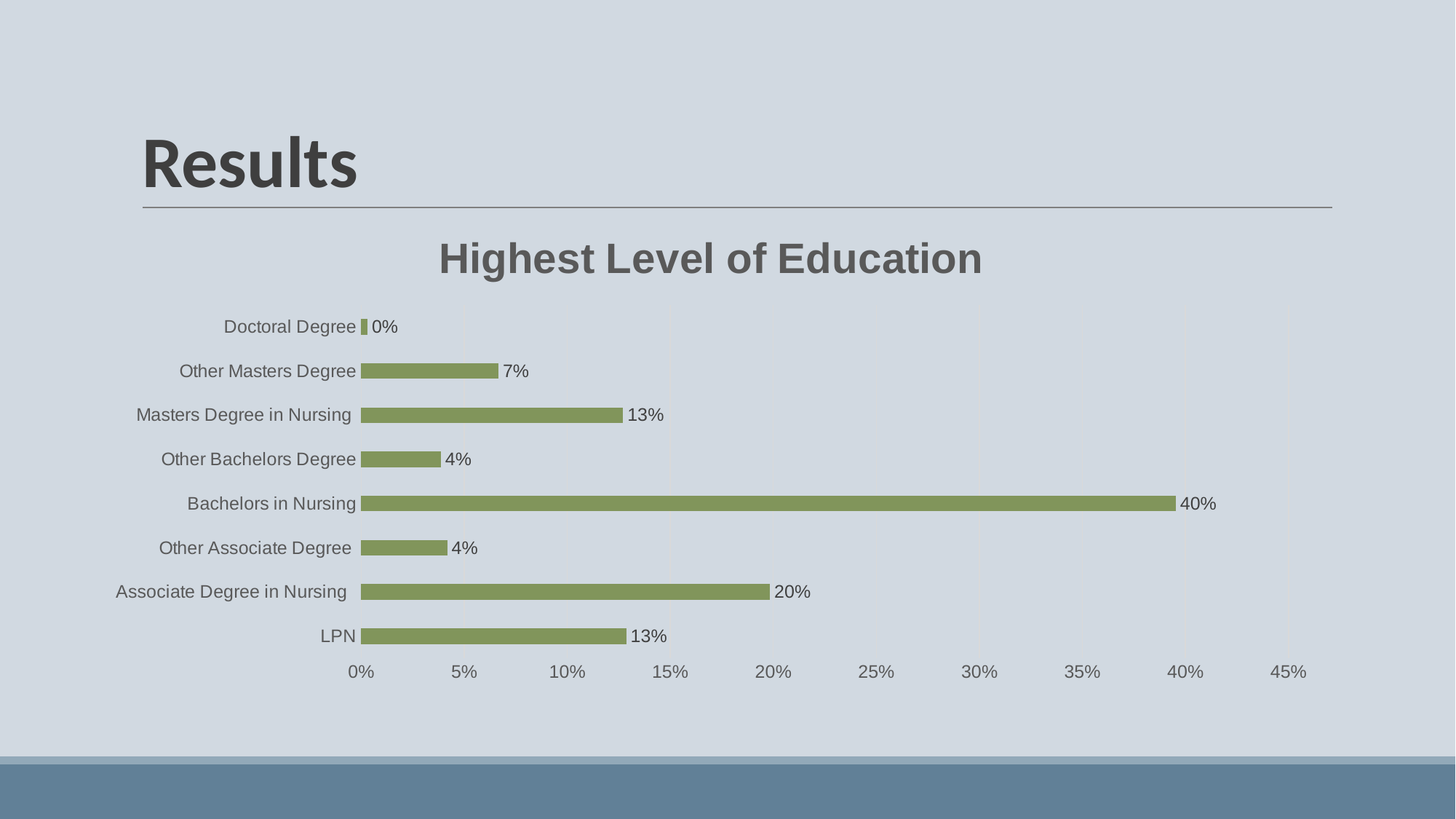
What is the title of the chart? Highest Level of Education How many categories are shown in the chart? 8 What is the value for LPN? 13% What is the value for Bachelors in Nursing? 40% What is the value for Other Masters Degree? 7% What is the value for Associate Degree in Nursing? 20% What kind of chart is shown on the slide? bar chart Which category has the highest value? Bachelors in Nursing Is the value for Associate Degree in Nursing greater or less than 15%? greater Which is larger, Masters Degree in Nursing or Other Masters Degree? Masters Degree in Nursing What is the difference between Bachelors in Nursing and Associate Degree in Nursing? 20% Which category has the lowest value? Doctoral Degree